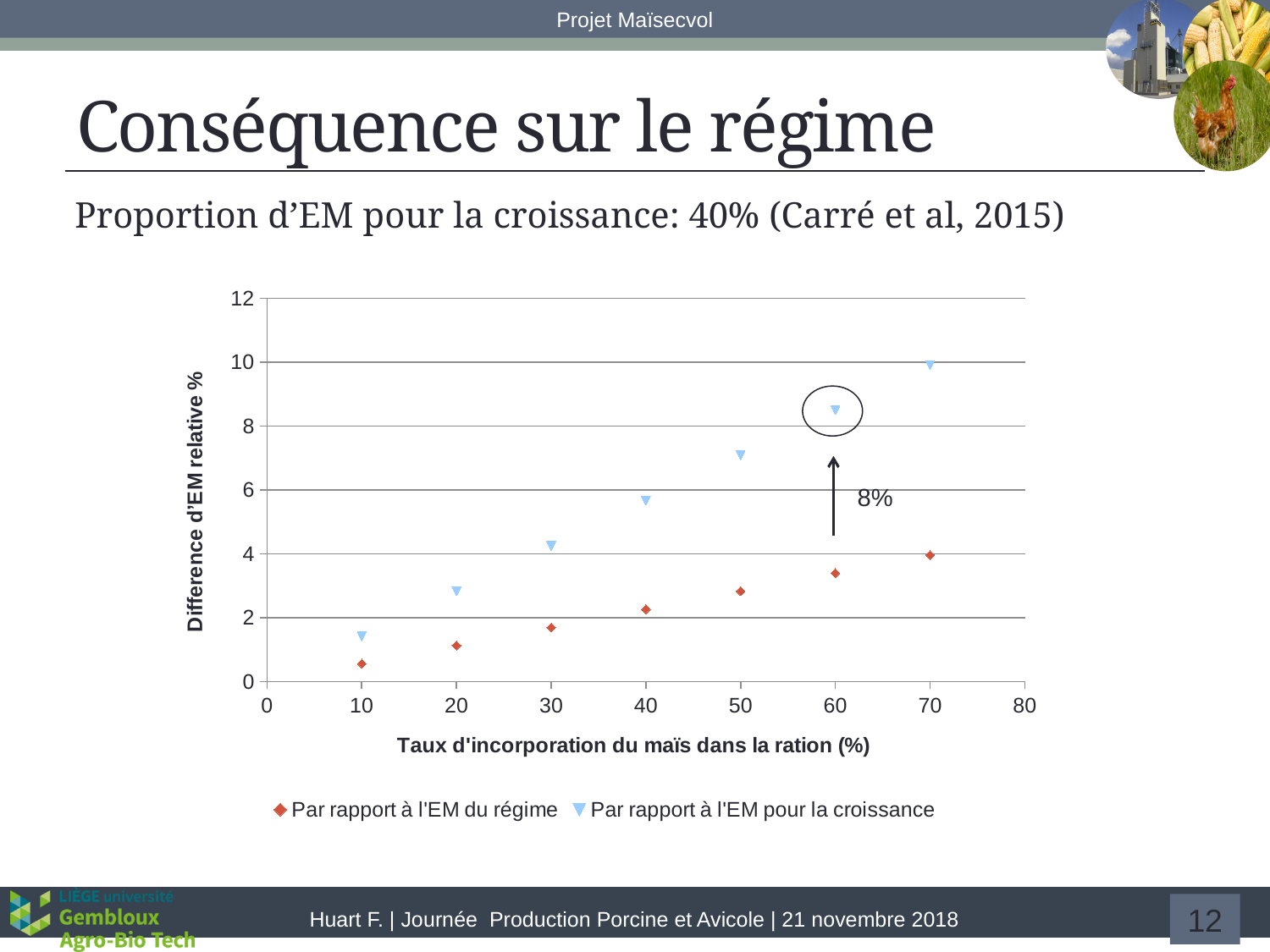
At an incorporation rate of 60%, which series has the larger value: 'Par rapport à l'EM du régime' or 'Par rapport à l'EM pour la croissance'? Par rapport à l'EM pour la croissance How many series does the legend list? 2 What percentage is written next to the arrow pointing to the circled point at 60%? 8% Is the value for 'Par rapport à l'EM du régime' at 60% greater or less than 4? less Is the value for 'Par rapport à l'EM du régime' at 10% greater or less than 2? less Do the values of the series 'Par rapport à l'EM du régime' rise or fall as the incorporation rate increases along the x axis? rise What kind of chart is shown on the slide? scatter chart What is the title of the x axis? Taux d'incorporation du maïs dans la ration (%) Is the value for 'Par rapport à l'EM pour la croissance' at 60% greater or less than 8? greater At which incorporation rate does the series 'Par rapport à l'EM pour la croissance' reach its highest value? 70 How many data points are plotted for the series 'Par rapport à l'EM pour la croissance'? 7